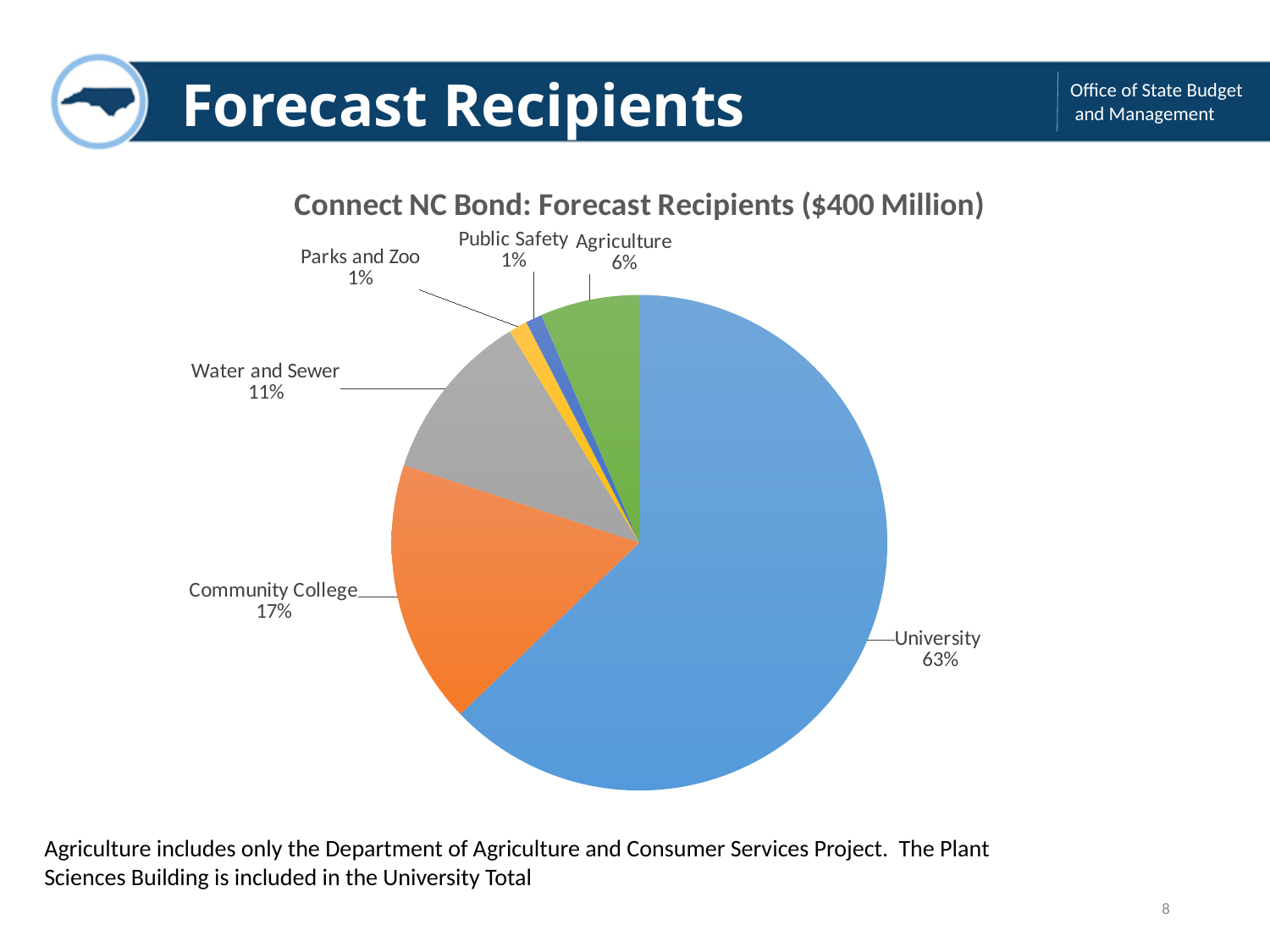
What share of the pie does Community College represent? 17% What kind of chart is shown on the slide? pie chart What is the difference in percentage points between University and Community College? 46 How many categories are shown in the pie chart? 6 What is the combined share of Parks and Zoo and Public Safety? 2% What share of the pie does University represent? 63% Which is larger, the share for Water and Sewer or the share for Agriculture? Water and Sewer What colour is the University slice? blue What share of the pie does Agriculture represent? 6% What is the title of the chart? Connect NC Bond: Forecast Recipients ($400 Million) Which category has the largest share of the pie? University